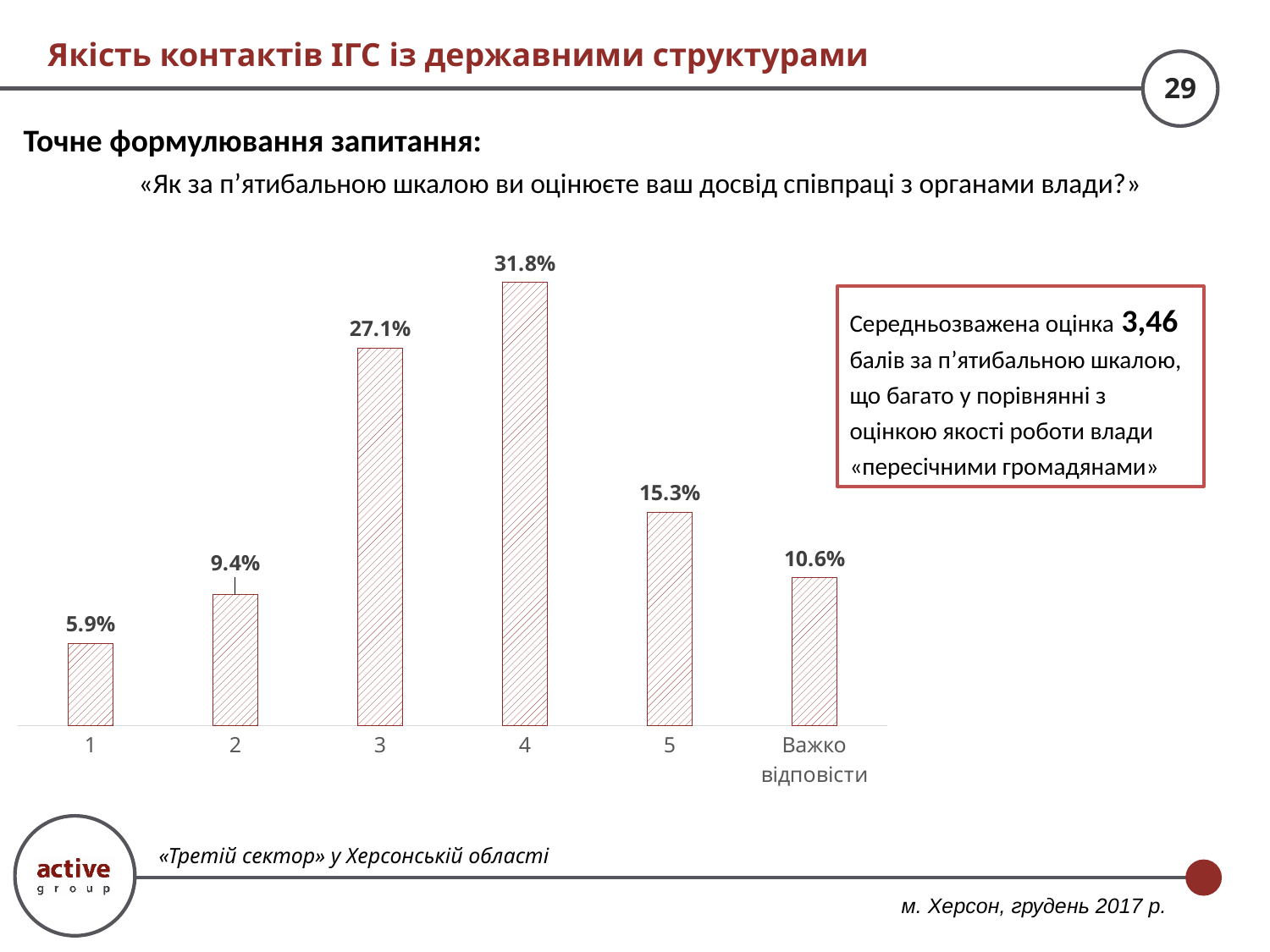
Which is larger, the value for category 2 or the value for category 5? 5 What is the value for category 1? 5.9% What kind of chart is shown on the slide? bar chart What weighted average score is stated in the text box next to the chart? 3,46 What is the value for the "Важко відповісти" category? 10.6% Do the values rise or fall from category 1 to category 4? rise What is the value for category 4? 31.8% Which category has the highest value? 4 What is the difference between the values for category 4 and category 3? 4.7% How many categories are shown on the x axis? 6 Which category has the lowest value? 1 What is the value for category 5? 15.3%